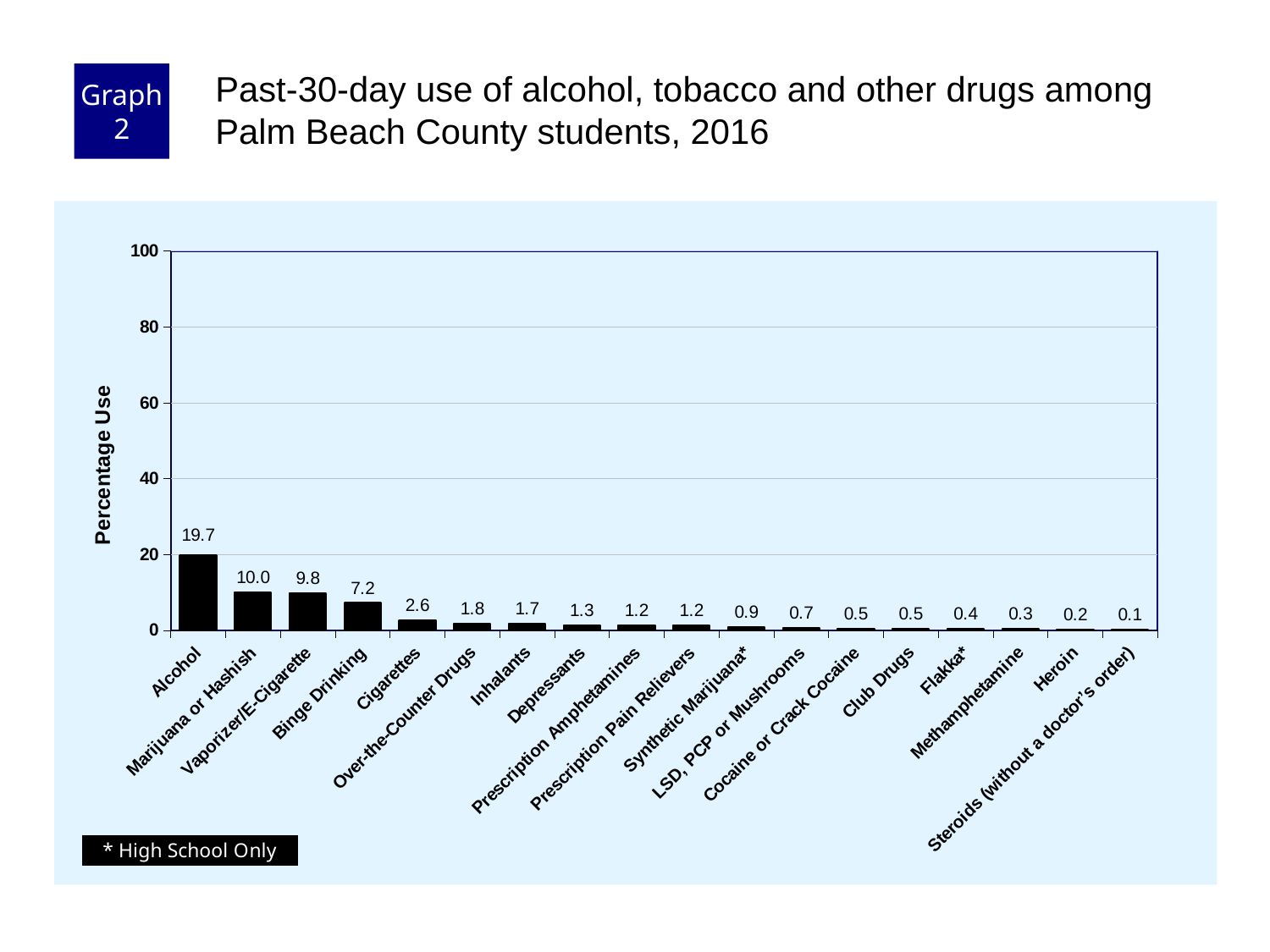
Which has a higher percentage use, Vaporizer/E-Cigarette or Binge Drinking? Vaporizer/E-Cigarette Is the value for Alcohol greater or less than 40? less What is the percentage use for Alcohol? 19.7 Which category has the lowest percentage use? Steroids (without a doctor's order) Which category has the highest percentage use? Alcohol What is the percentage use for Binge Drinking? 7.2 What is the percentage use for Cigarettes? 2.6 What is the label of the y axis? Percentage Use What is the percentage use for Heroin? 0.2 What kind of chart is shown on the slide? Bar chart How many categories are shown on the x axis? 18 What is the difference in percentage use between Alcohol and Marijuana or Hashish? 9.7